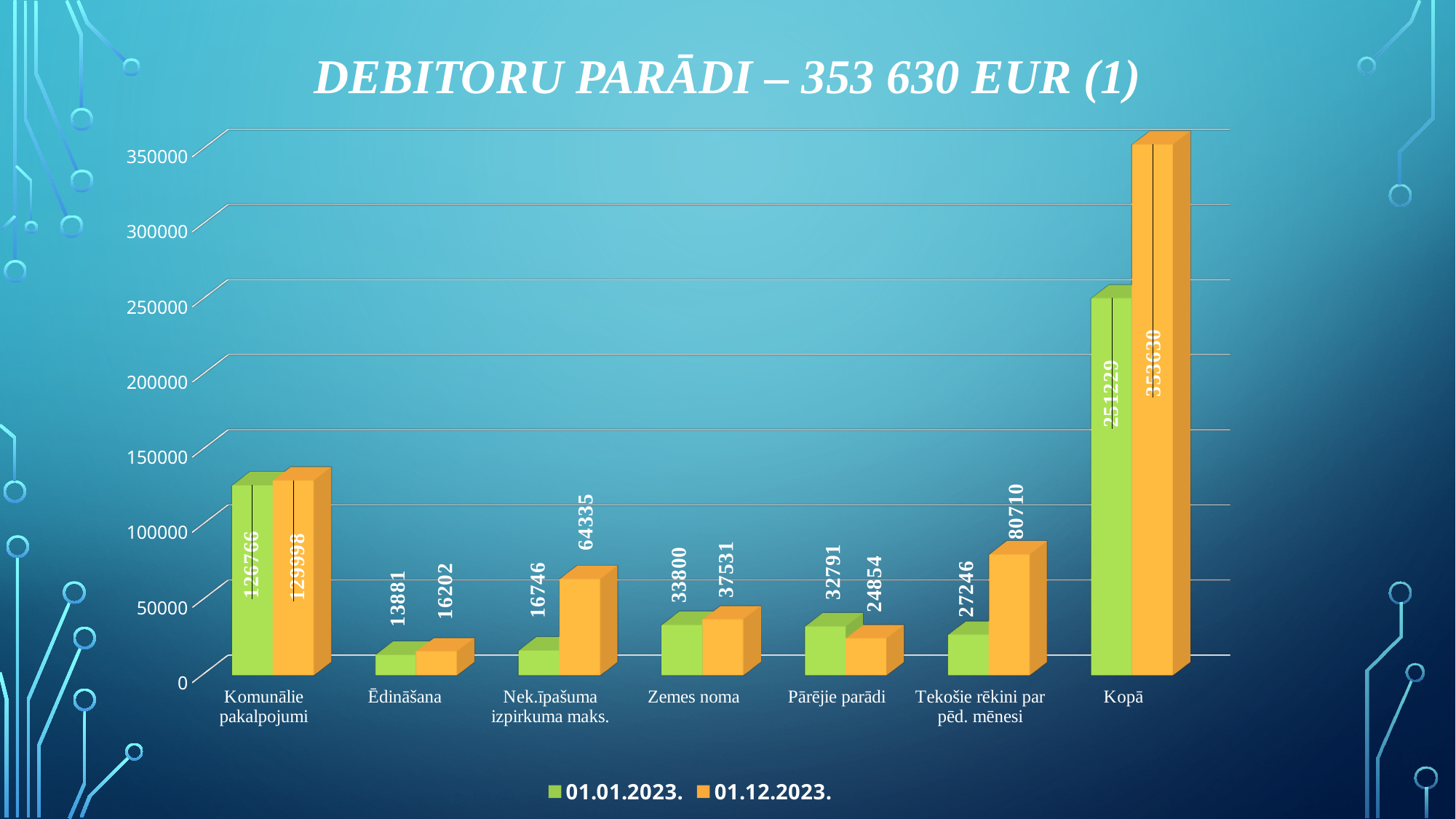
How many series does the legend list? 2 What is the value for Komunālie pakalpojumi in the 01.01.2023. series? 126766 What is the value for Tekošie rēkini par pēd. mēnesi in the 01.12.2023. series? 80710 What is the value for Nek.īpašuma izpirkuma maks. in the 01.12.2023. series? 64335 How many categories are shown on the x axis? 7 What is the difference between the 01.12.2023. and 01.01.2023. values for Kopā? 102401 What is the difference between the 01.12.2023. and 01.01.2023. values for Tekošie rēkini par pēd. mēnesi? 53464 Excluding Kopā, which category has the lowest value in the 01.01.2023. series? Ēdināšana What is the value for Pārējie parādi in the 01.01.2023. series? 32791 For Pārējie parādi, which series has the larger value, 01.01.2023. or 01.12.2023.? 01.01.2023. Excluding Kopā, which category has the highest value in the 01.12.2023. series? Komunālie pakalpojumi What kind of chart is shown on the slide? Bar chart